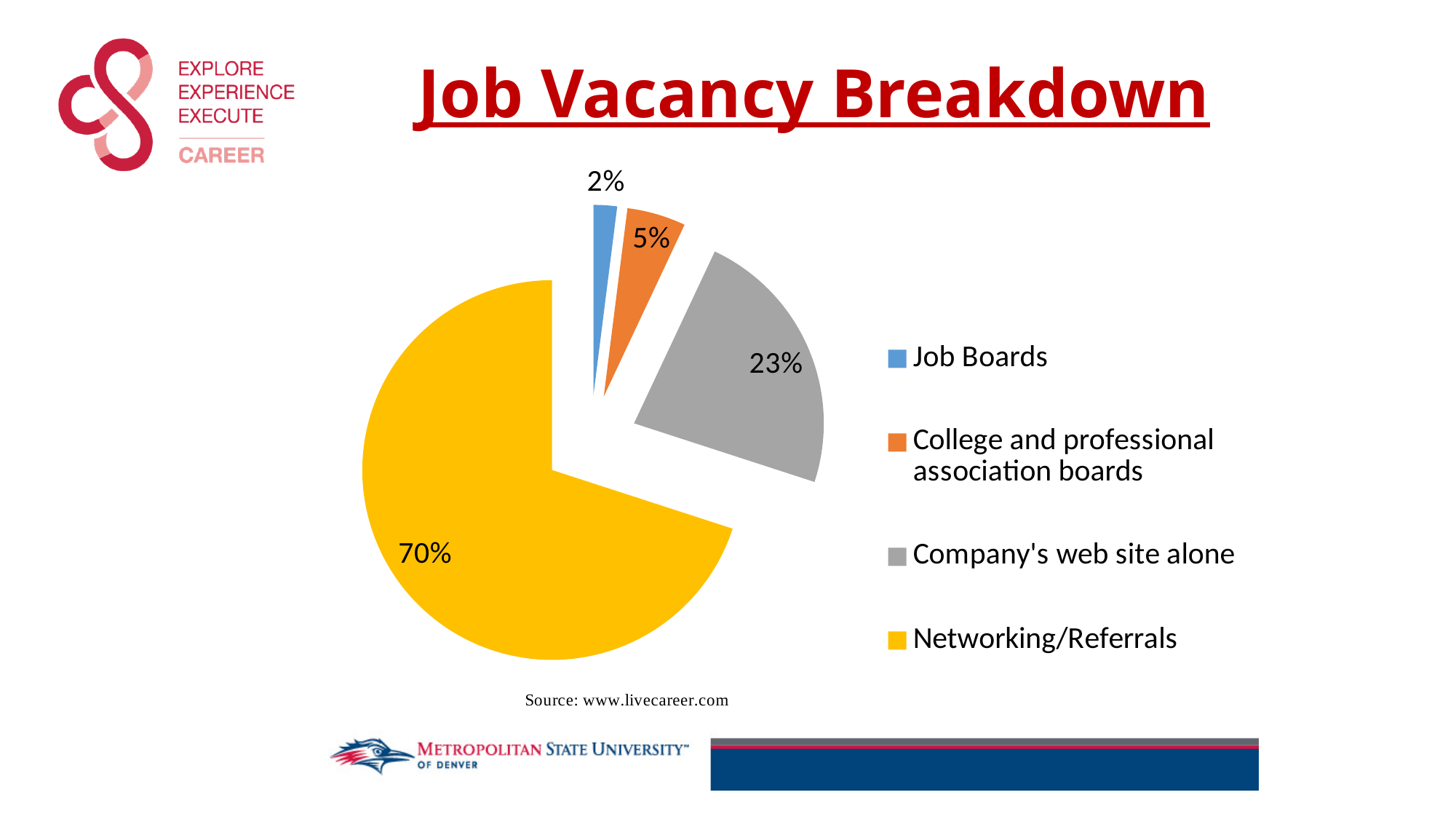
How many categories does the pie chart show? 4 What percentage of job vacancies is attributed to Company's web site alone? 23% Which category has the largest share of the pie? Networking/Referrals Which is larger, the share for College and professional association boards or the share for Job Boards? College and professional association boards What percentage of job vacancies is attributed to College and professional association boards? 5% What is the title of the chart? Job Vacancy Breakdown What kind of chart is shown on the slide? pie chart What colour is the slice for Company's web site alone? gray Which category has the smallest share of the pie? Job Boards What is the difference in percentage points between Networking/Referrals and Company's web site alone? 47 What percentage of job vacancies is attributed to Job Boards? 2% What percentage of job vacancies is attributed to Networking/Referrals? 70%